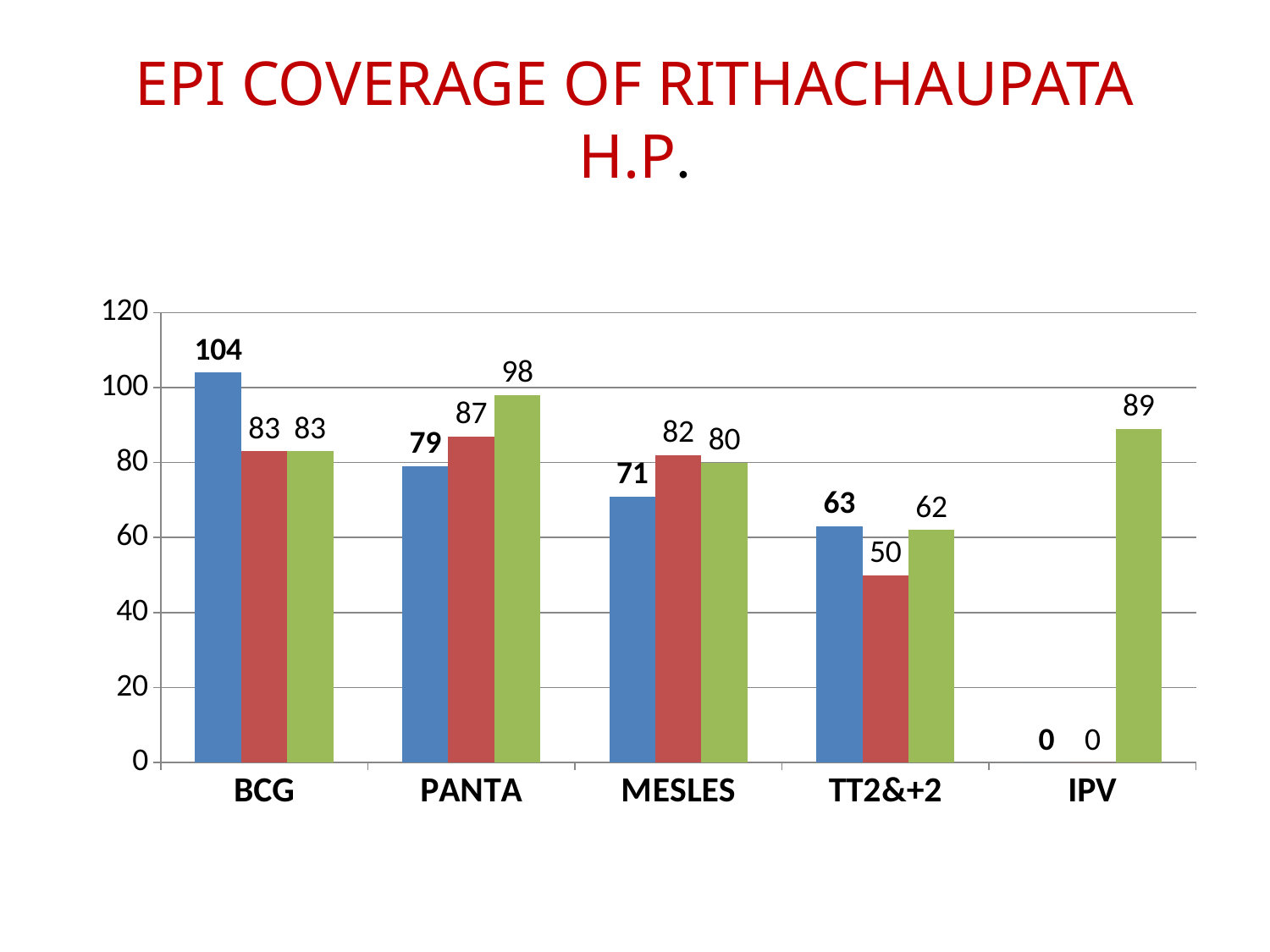
Which is larger for MESLES, the red bar or the blue bar? the red bar What is the difference between the green bar and the blue bar for PANTA? 19 What is the value of the green bar for PANTA? 98 What kind of chart is shown on the slide? bar chart How many categories are shown on the x axis? 5 What is the title of the slide? EPI COVERAGE OF RITHACHAUPATA H.P. What is the value of the blue bar for BCG? 104 Which category has the highest blue bar? BCG What is the difference between the blue bar and the red bar for BCG? 21 What is the value of the green bar for IPV? 89 What is the value of the red bar for TT2&+2? 50 Which category has the lowest red bar? IPV